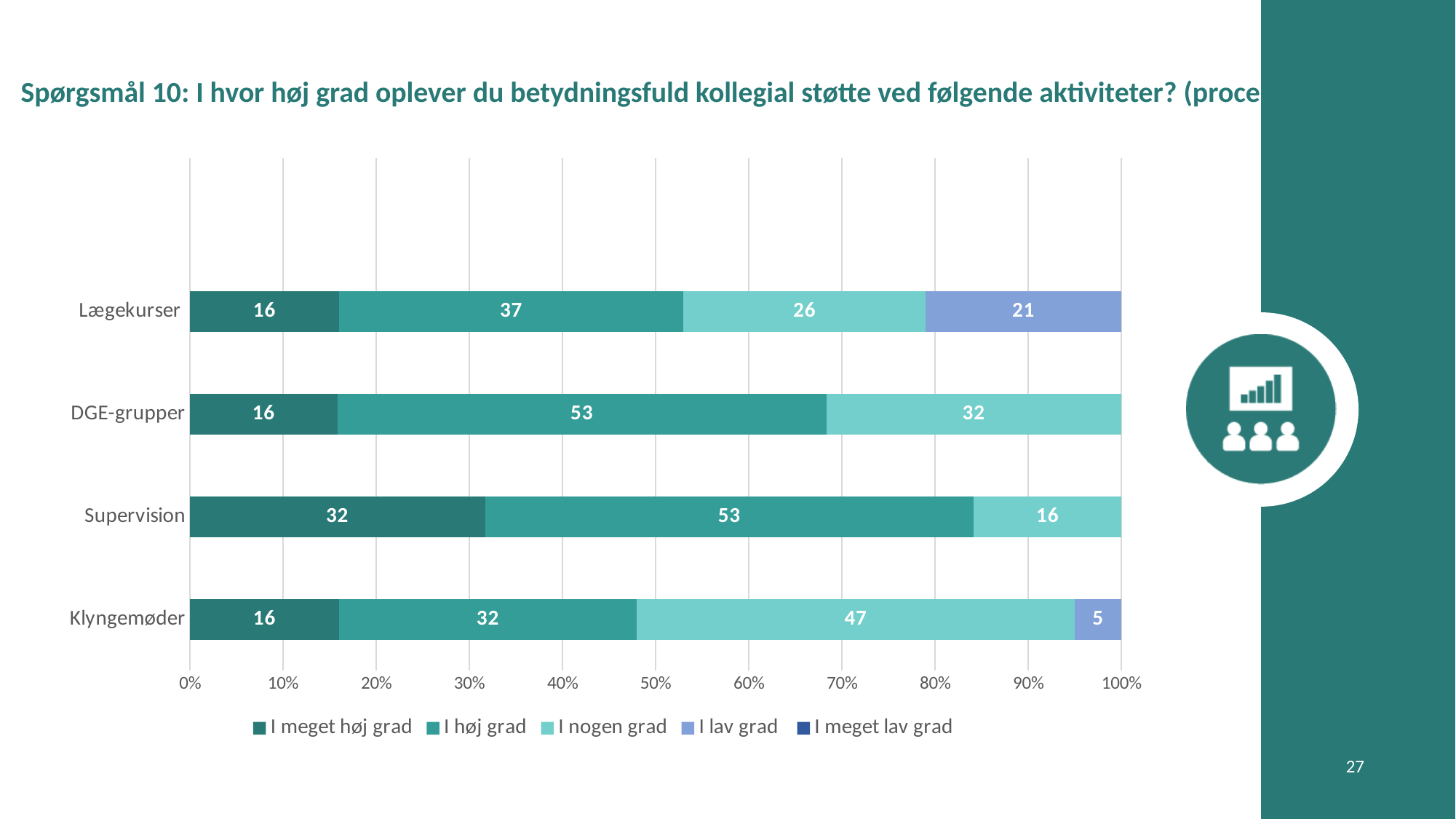
Which category has the highest value for 'I meget høj grad'? Supervision How many series does the legend list? 5 How many activity categories are plotted on the chart? 4 What is the value of 'I høj grad' for DGE-grupper? 53 What is the value of 'I nogen grad' for Klyngemøder? 47 Which legend entry is shown in the lightest teal colour? I nogen grad What is the value of 'I meget høj grad' for Supervision? 32 Which category has the lowest value for 'I nogen grad'? Supervision What is the difference between the 'I høj grad' values for Supervision and Klyngemøder? 21 What kind of chart is shown on the slide? Stacked bar chart What is the value of 'I lav grad' for Lægekurser? 21 Which is larger: the 'I nogen grad' value for Lægekurser or for DGE-grupper? DGE-grupper